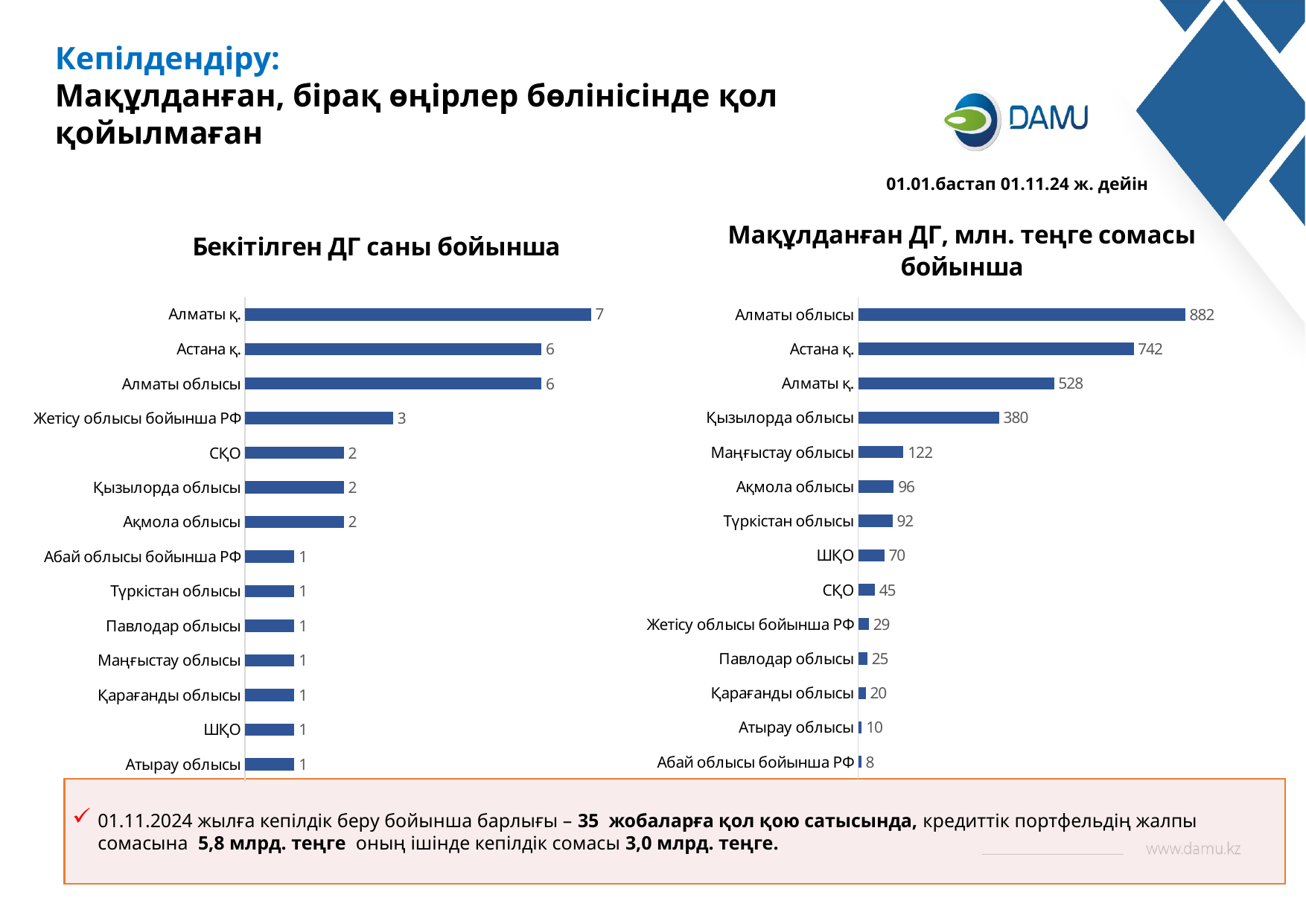
In the chart 'Мақұлданған ДГ, млн. теңге сомасы бойынша', what is the value for Қызылорда облысы? 380 In the chart 'Мақұлданған ДГ, млн. теңге сомасы бойынша', which is larger: the value for Ақмола облысы or Түркістан облысы? Ақмола облысы What type of chart is 'Мақұлданған ДГ, млн. теңге сомасы бойынша'? Bar chart In the chart 'Мақұлданған ДГ, млн. теңге сомасы бойынша', what is the difference between the values for Алматы облысы and Астана қ.? 140 In the chart 'Мақұлданған ДГ, млн. теңге сомасы бойынша', what is the value for Маңғыстау облысы? 122 In the chart 'Бекітілген ДГ саны бойынша', which category has the highest value? Алматы қ. In the chart 'Мақұлданған ДГ, млн. теңге сомасы бойынша', which category has the lowest value? Абай облысы бойынша РФ In the chart 'Бекітілген ДГ саны бойынша', how many categories are shown? 14 In the chart 'Бекітілген ДГ саны бойынша', what is the value for Жетісу облысы бойынша РФ? 3 In the chart 'Бекітілген ДГ саны бойынша', what is the value for Алматы қ.? 7 In the chart 'Мақұлданған ДГ, млн. теңге сомасы бойынша', which category has the highest value? Алматы облысы In the chart 'Бекітілген ДГ саны бойынша', what is the difference between the values for Алматы қ. and Астана қ.? 1